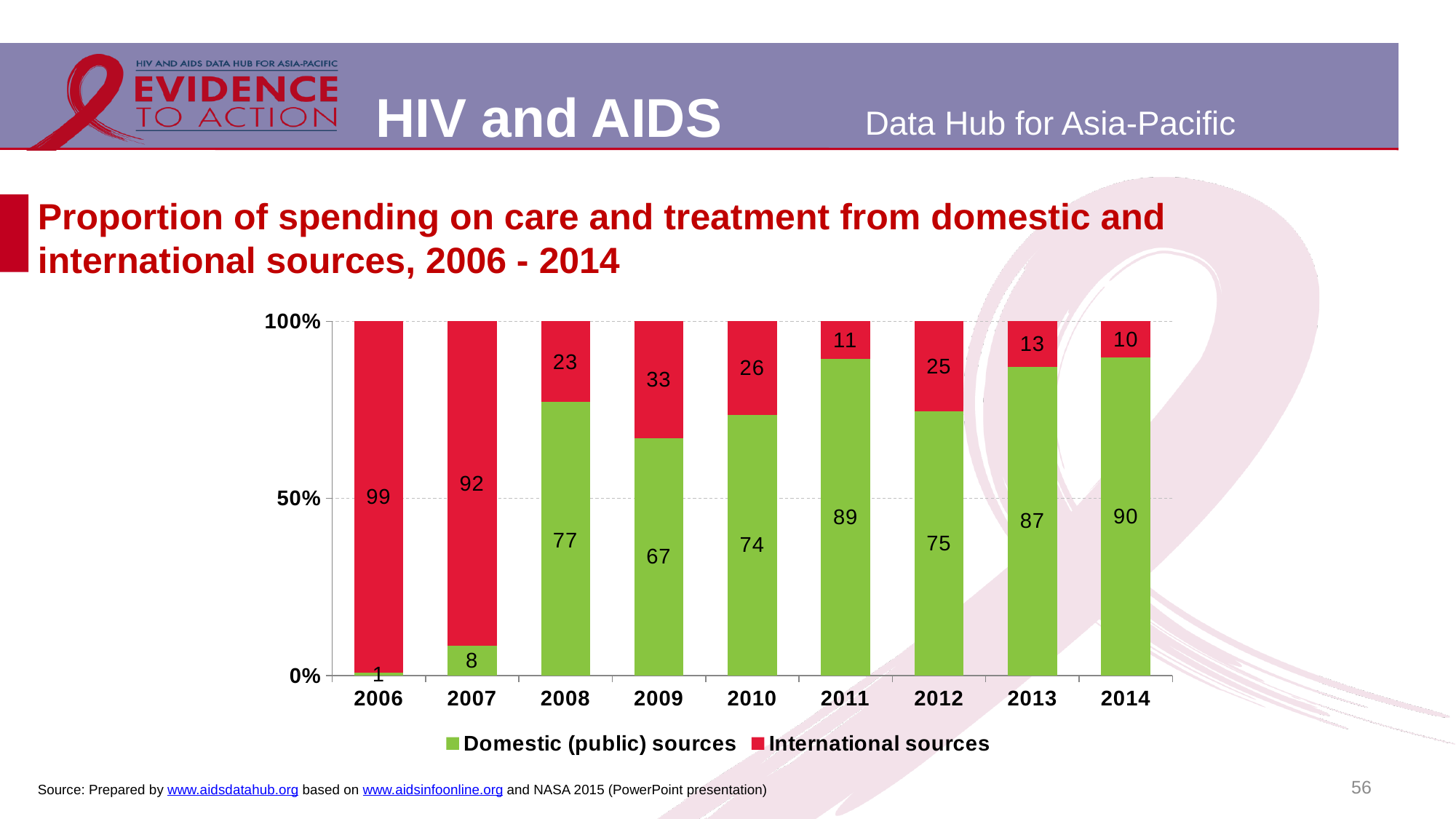
What is the value for Domestic (public) sources in 2006? 1 How many series does the legend list? 2 What kind of chart is shown on the slide? Stacked bar chart What is the value for Domestic (public) sources in 2014? 90 Is the Domestic (public) sources value for 2007 greater or less than 50%? less Which year has the lowest value for Domestic (public) sources? 2006 How many years are shown on the x axis? 9 What is the difference between the Domestic (public) sources values for 2011 and 2009? 22 Which year has the highest value for International sources? 2006 Which colour represents International sources in the chart? Red What is the value for International sources in 2009? 33 Which is larger, the International sources value for 2008 or for 2012? 2012